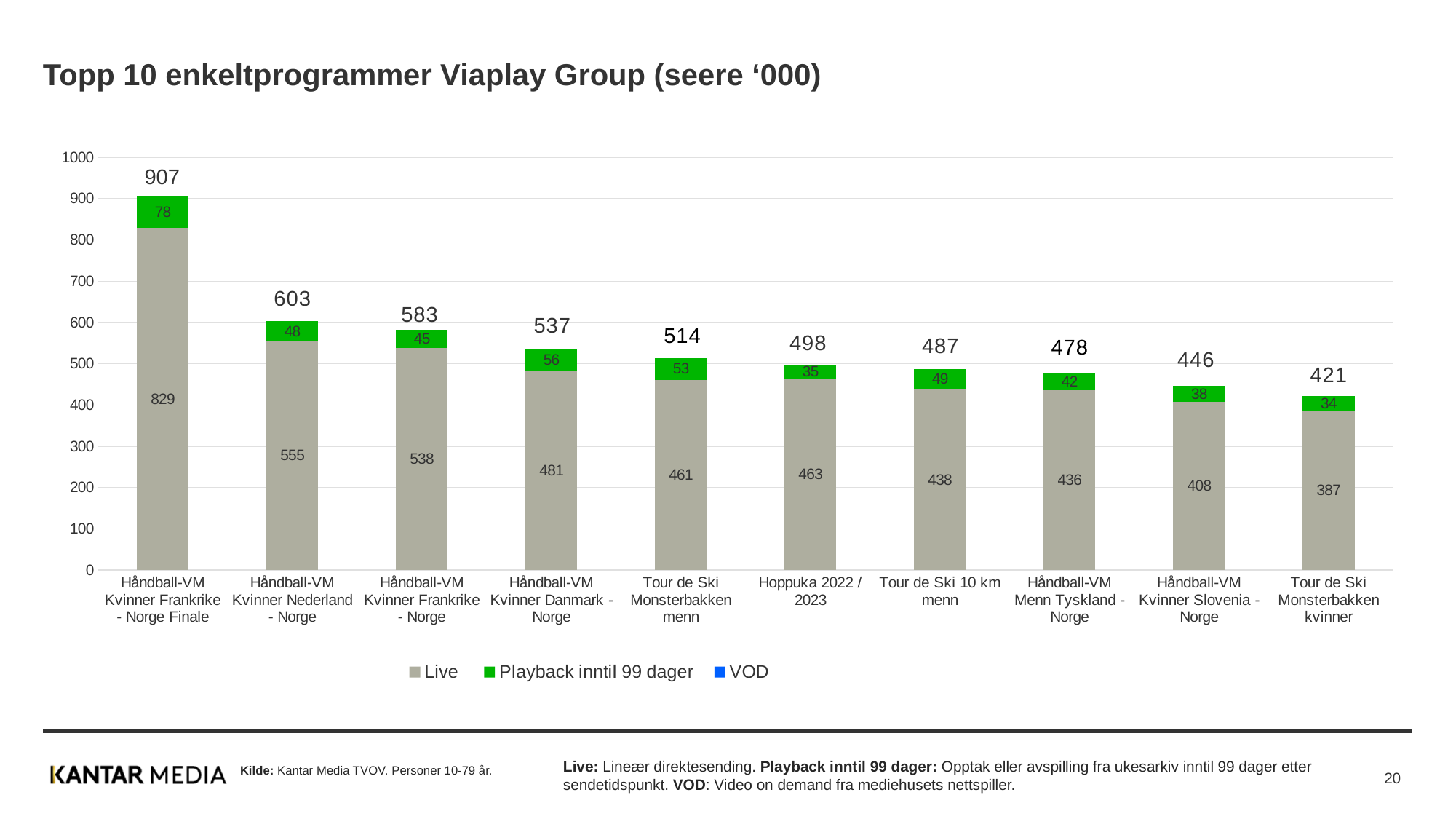
Which programme has the highest total viewers? Håndball-VM Kvinner Frankrike - Norge Finale How many programmes (categories) are shown in the chart? 10 Which series in the legend is shown in green? Playback inntil 99 dager Which has a larger Live value: Hoppuka 2022 / 2023 or Tour de Ski 10 km menn? Hoppuka 2022 / 2023 What is the Playback inntil 99 dager value for Håndball-VM Kvinner Danmark - Norge? 56 What is the total number of viewers ('000) for Håndball-VM Kvinner Frankrike - Norge Finale? 907 Do the total values rise or fall from left to right across the chart? Fall Which programme has the lowest total viewers? Tour de Ski Monsterbakken kvinner What is the Live value for Håndball-VM Kvinner Nederland - Norge? 555 What is the difference in total viewers between Håndball-VM Kvinner Frankrike - Norge Finale (907) and Håndball-VM Kvinner Nederland - Norge (603)? 304 What type of chart is shown on the slide? Stacked bar chart How many series does the legend list? 3